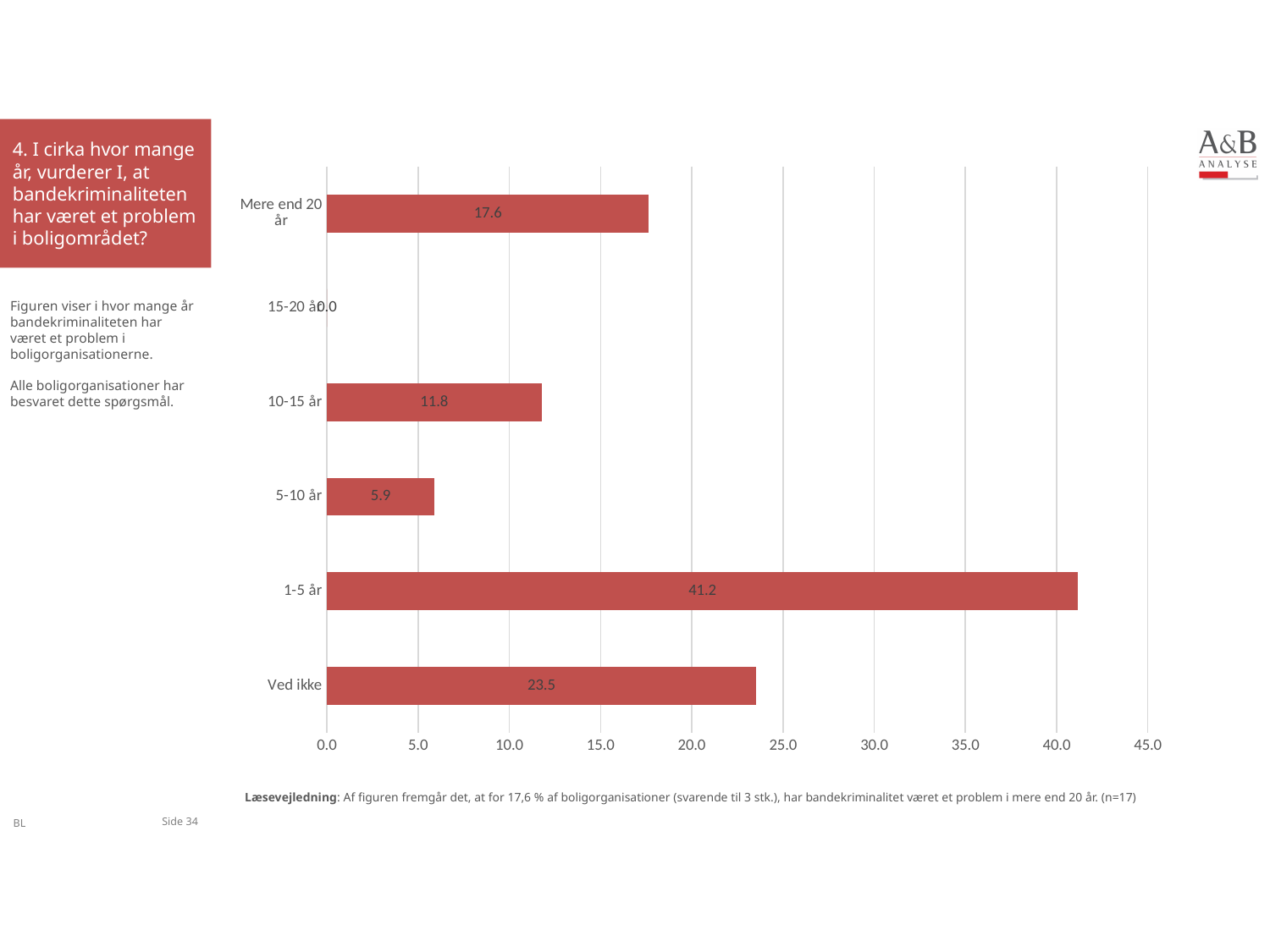
What is the value for "Mere end 20 år"? 17.6 Which is larger, the value for "10-15 år" or the value for "5-10 år"? 10-15 år Which category has the highest value? 1-5 år What is the value for "1-5 år"? 41.2 Is the value for "Ved ikke" greater or less than 20.0? greater Which category has the lowest value? 15-20 år What is the value for "15-20 år"? 0.0 What is the highest value shown on the x axis? 45.0 How many categories are shown on the chart? 6 What kind of chart is shown on the slide? Bar chart What is the value for "Ved ikke"? 23.5 What is the difference between the values for "1-5 år" and "Ved ikke"? 17.7